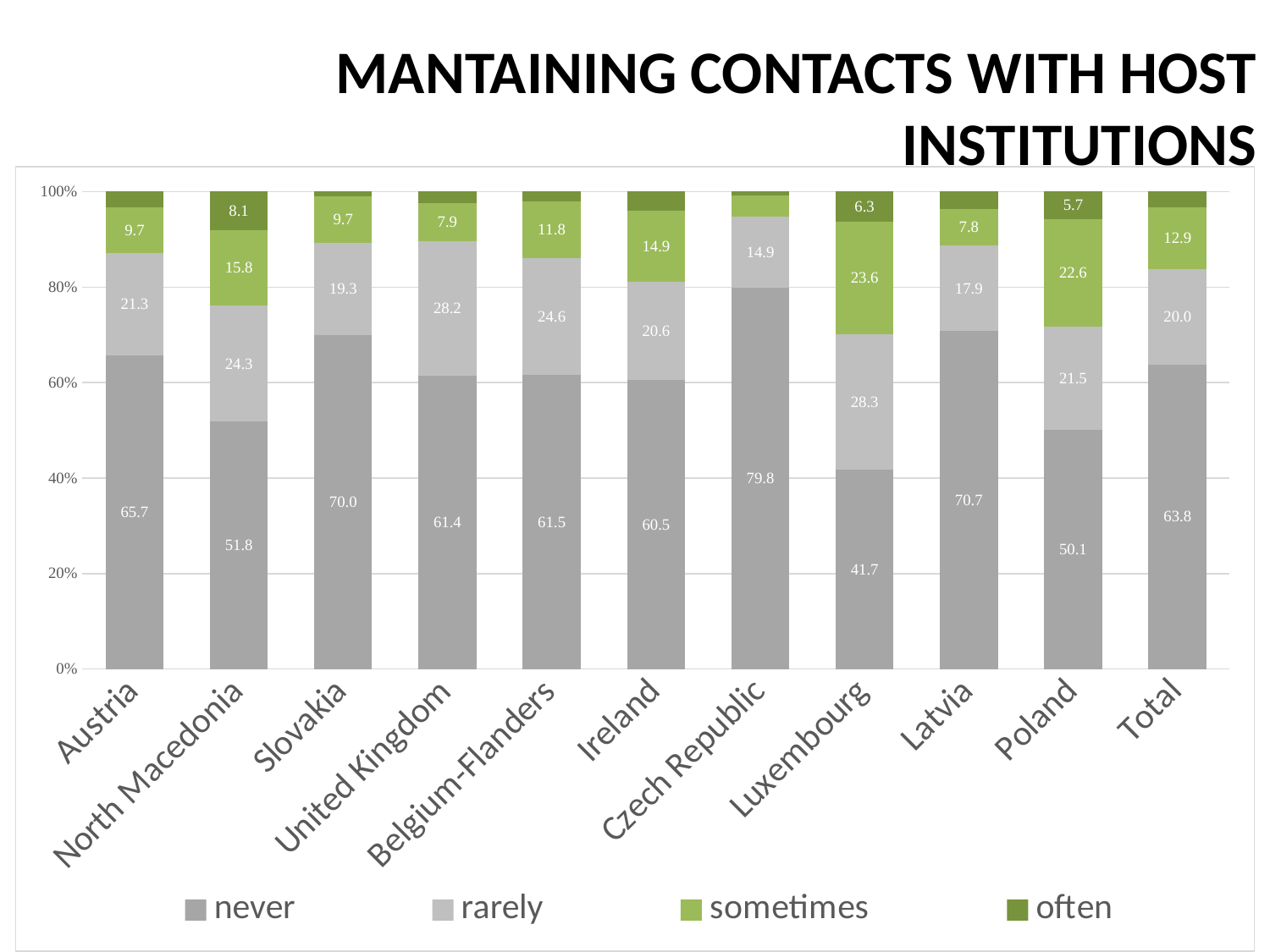
What is the 'rarely' value for Luxembourg? 28.3 What is the 'often' value for North Macedonia? 8.1 Which category has the highest 'never' value? Czech Republic What is the difference between the 'never' values for Austria and Poland? 15.6 What kind of chart is shown on the slide? Stacked bar chart What is the 'sometimes' value for Poland? 22.6 What are the four legend entries of the chart? never, rarely, sometimes, often What is the 'never' value for Czech Republic? 79.8 How many series does the legend list? 4 Which has the larger 'rarely' value, Belgium-Flanders or Ireland? Belgium-Flanders Which category has the lowest 'never' value? Luxembourg How many categories are shown on the x axis? 11